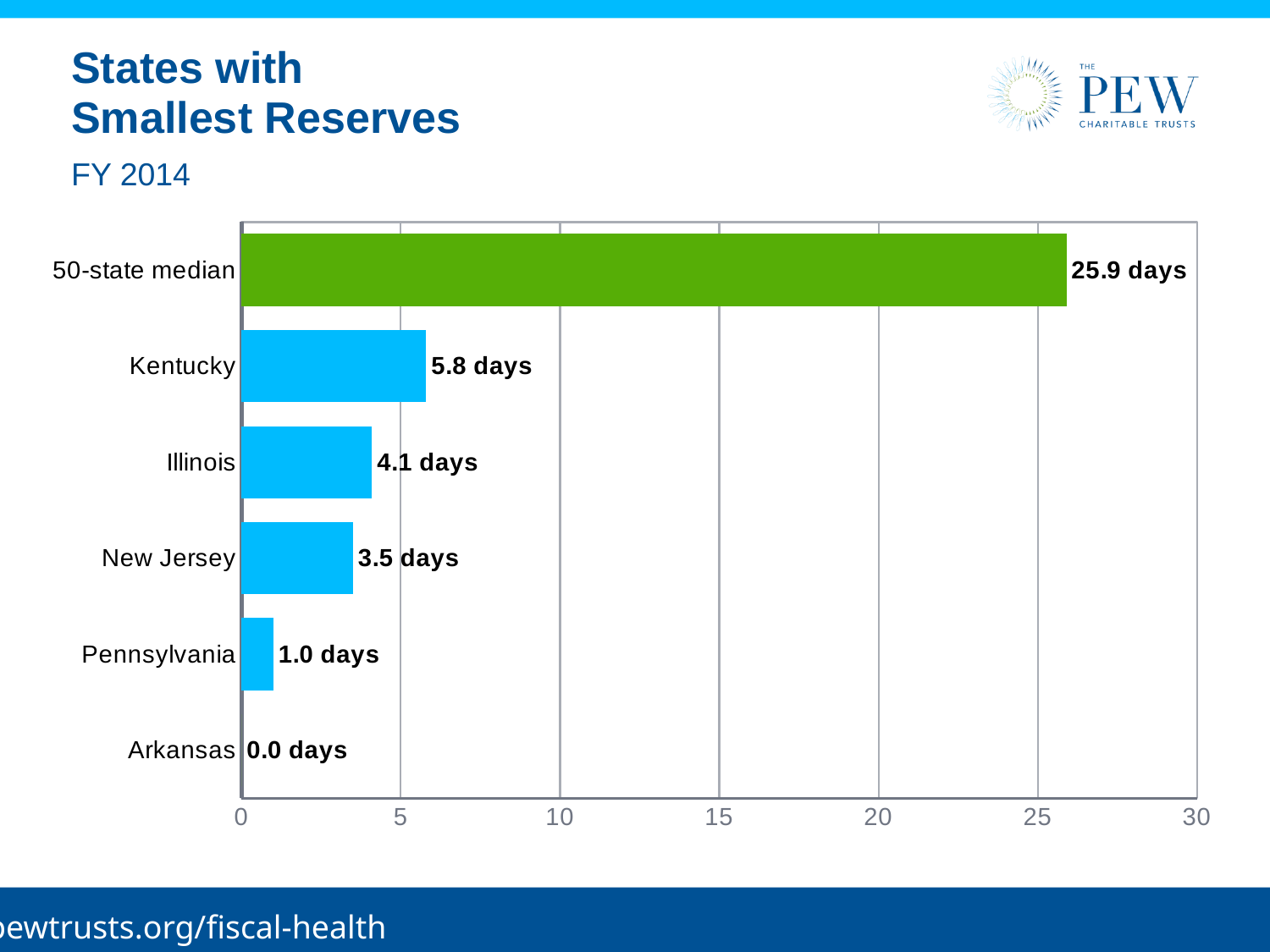
Is the value for Kentucky greater or less than 5? greater What kind of chart is shown on the slide? Bar chart Which category has the highest value? 50-state median Which is larger, the value for Illinois or the value for New Jersey? Illinois What is the value for the 50-state median? 25.9 days What is the value for Pennsylvania? 1.0 days What is the difference between Illinois and New Jersey? 0.6 days What is the difference between the 50-state median and Kentucky? 20.1 days What fiscal year does the chart cover? FY 2014 Which category has the lowest value? Arkansas How many categories are shown on the chart? 6 What is the value for Kentucky? 5.8 days